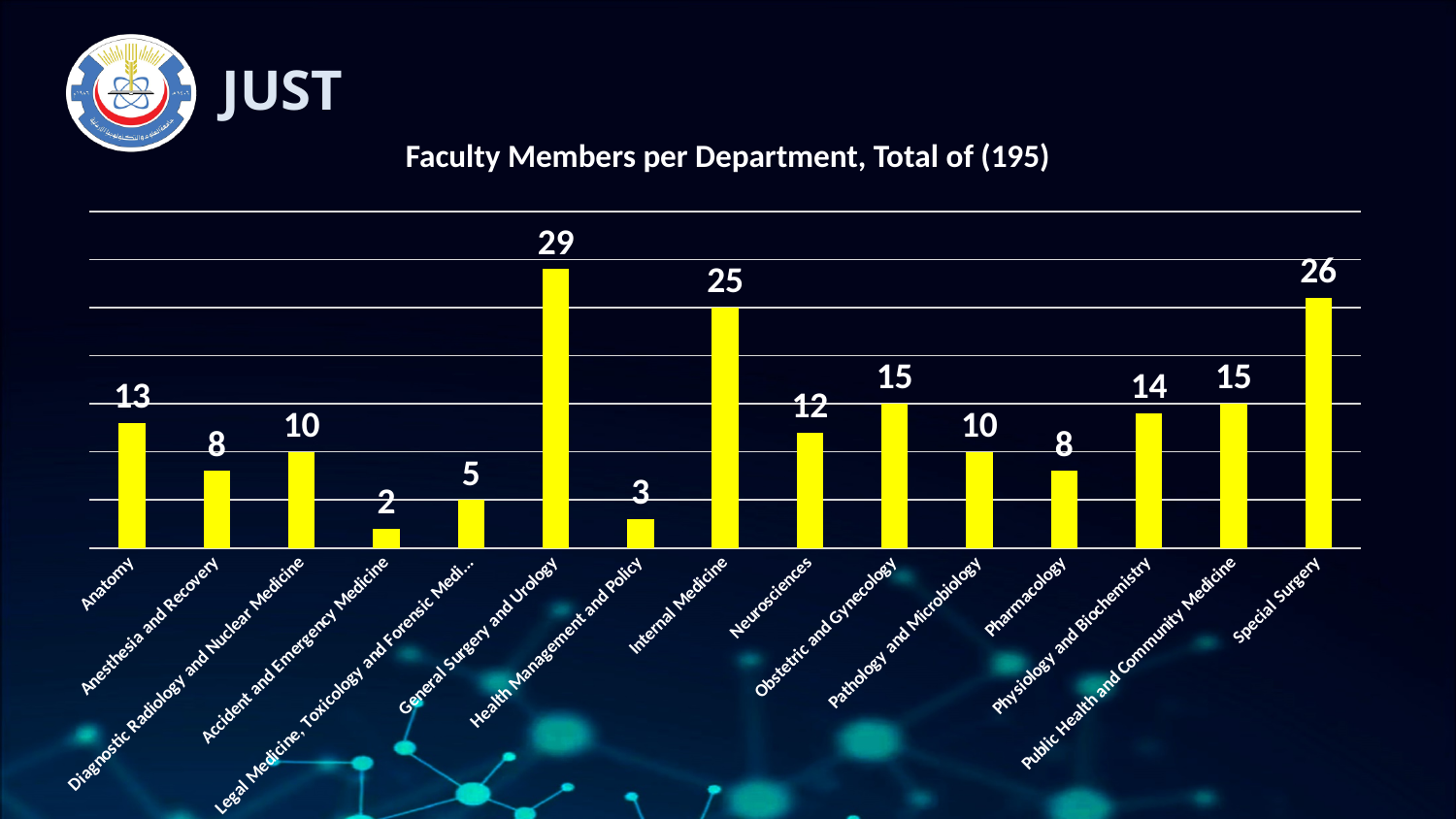
Which has more faculty members, Neurosciences or Obstetric and Gynecology? Obstetric and Gynecology What type of chart is shown on the slide? Bar chart Which department has the highest number of faculty members? General Surgery and Urology What is the title of the chart? Faculty Members per Department, Total of (195) Which department has the lowest number of faculty members? Accident and Emergency Medicine How many departments are shown on the chart? 15 What is the difference between the values for Special Surgery and Internal Medicine? 1 What is the value shown for Internal Medicine? 25 What is the difference between the values for General Surgery and Urology and Health Management and Policy? 26 What is the value for Physiology and Biochemistry? 14 How many faculty members are in the Anatomy department? 13 How many faculty members does the General Surgery and Urology department have? 29